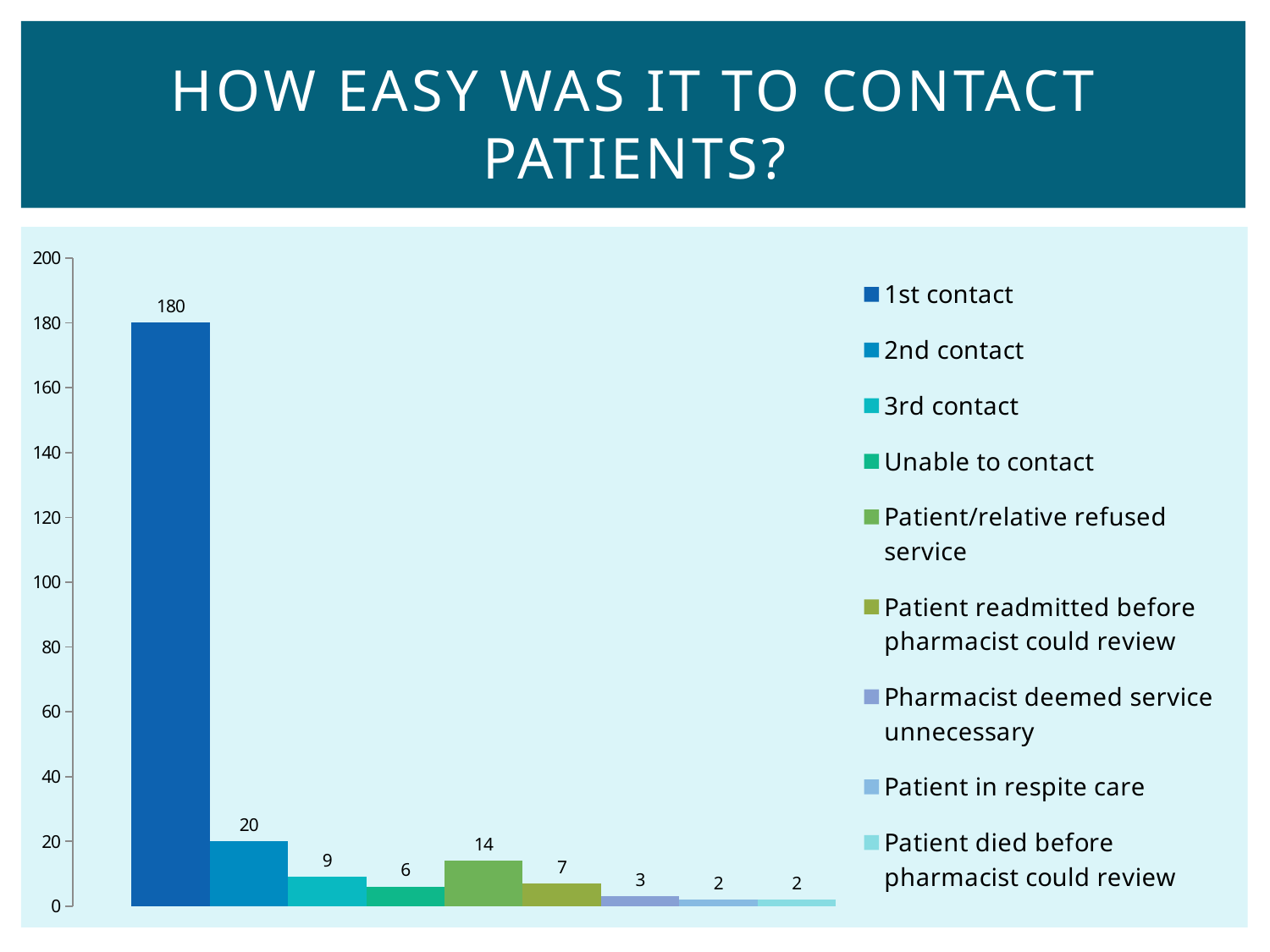
Which category has the highest value? 1st contact Is the value for 1st contact greater or less than 160? greater What is the value for Pharmacist deemed service unnecessary? 3 What is the value for 2nd contact? 20 Which is larger, the value for 3rd contact or the value for Unable to contact? 3rd contact What is the value for 1st contact? 180 How many bars are plotted in the chart? 9 What is the difference between the values for 1st contact and 2nd contact? 160 How many entries does the legend list? 9 What kind of chart is shown on the slide? Bar chart What is the title of the slide? HOW EASY WAS IT TO CONTACT PATIENTS? What is the value for Patient/relative refused service? 14